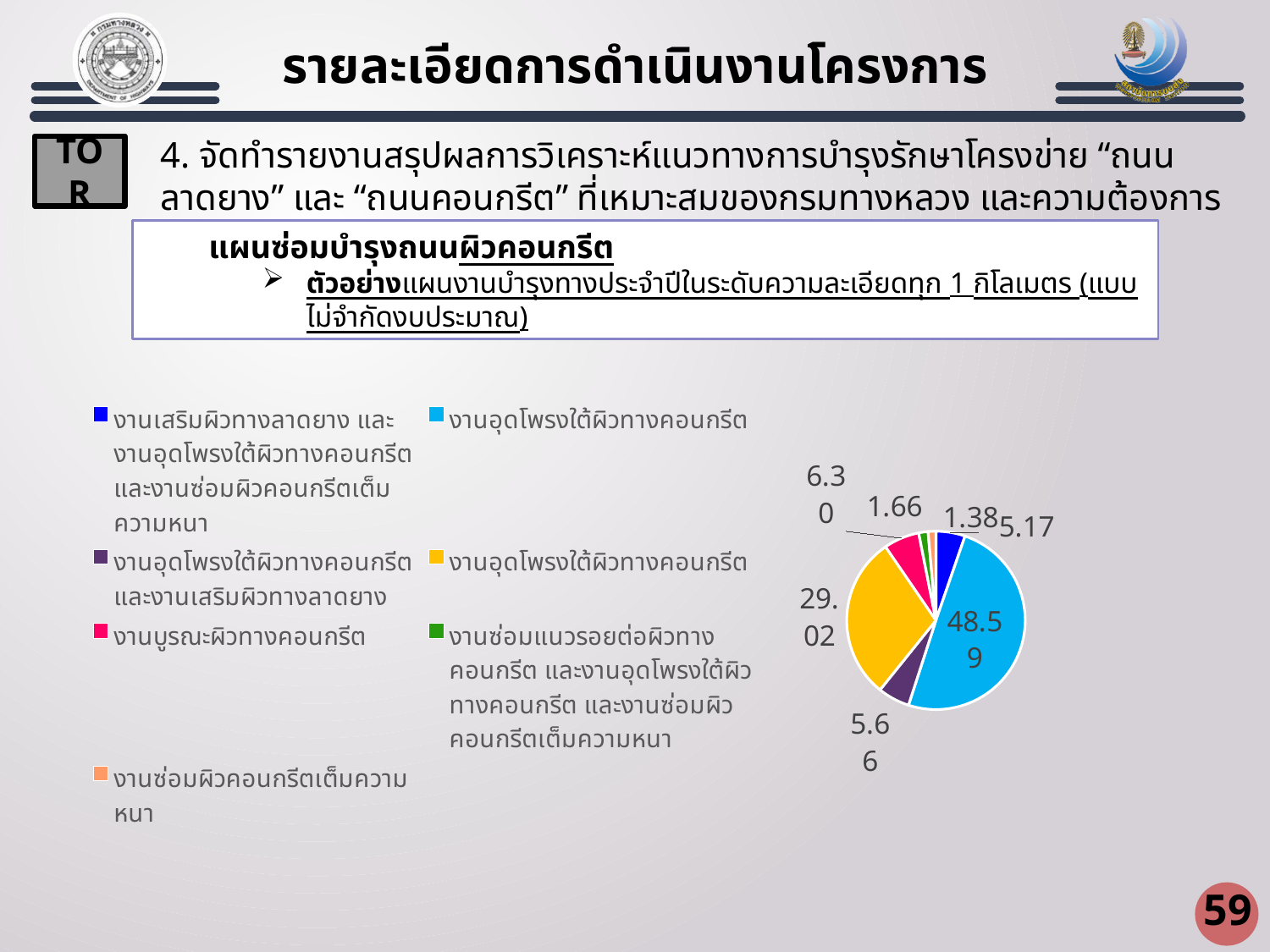
What is the value of the largest slice in the pie chart? 48.59 Which is larger: the slice for งานบูรณะผิวทางคอนกรีต or the slice for งานอุดโพรงใต้ผิวทางคอนกรีต และงานเสริมผิวทางลาดยาง? งานบูรณะผิวทางคอนกรีต What is the difference between the slice for งานบูรณะผิวทางคอนกรีต and the slice for งานอุดโพรงใต้ผิวทางคอนกรีต และงานเสริมผิวทางลาดยาง? 0.64 How many slices does the pie chart have? 7 What is the value of the slice for งานซ่อมแนวรอยต่อผิวทางคอนกรีต และงานอุดโพรงใต้ผิวทางคอนกรีต และงานซ่อมผิวคอนกรีตเต็มความหนา? 1.66 What is the value of the yellow slice in the pie chart? 29.02 What is the value of the slice for งานบูรณะผิวทางคอนกรีต? 6.30 What colour is the slice for งานบูรณะผิวทางคอนกรีต in the pie chart? pink What kind of chart is shown on the slide? pie chart What is the value of the slice for งานอุดโพรงใต้ผิวทางคอนกรีต และงานเสริมผิวทางลาดยาง? 5.66 What is the value of the slice for งานซ่อมผิวคอนกรีตเต็มความหนา? 1.38 Which category has the smallest slice in the pie chart? งานซ่อมผิวคอนกรีตเต็มความหนา